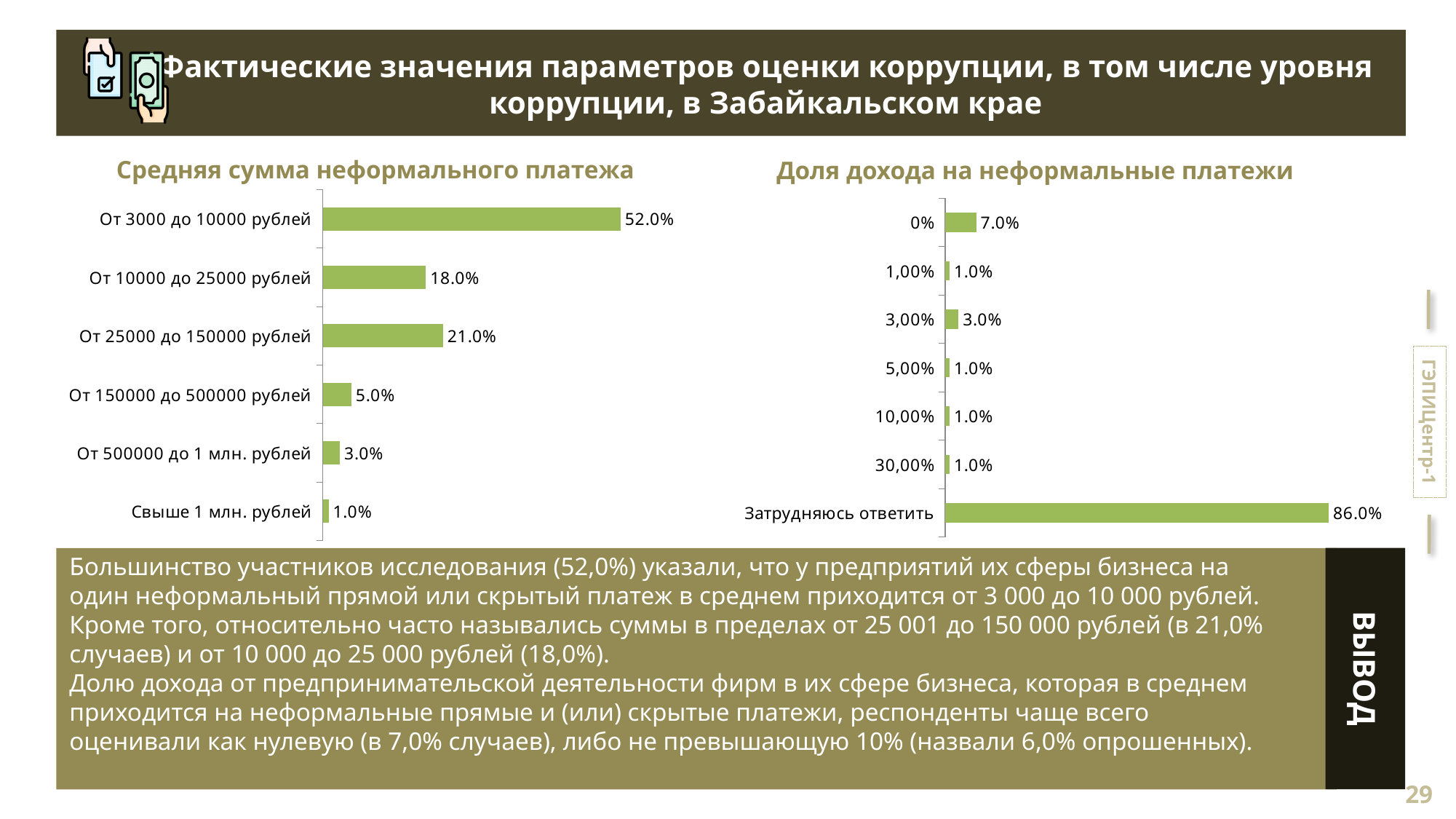
In the chart 'Доля дохода на неформальные платежи', what is the difference between '0%' and '3,00%'? 4.0% In the chart 'Средняя сумма неформального платежа', what is the difference between 'От 25000 до 150000 рублей' and 'От 10000 до 25000 рублей'? 3.0% In the chart 'Доля дохода на неформальные платежи', which category has the highest value? Затрудняюсь ответить How many categories are shown in the chart 'Доля дохода на неформальные платежи'? 7 In the chart 'Средняя сумма неформального платежа', which is larger: 'От 10000 до 25000 рублей' or 'От 25000 до 150000 рублей'? От 25000 до 150000 рублей In the chart 'Средняя сумма неформального платежа', which category has the lowest value? Свыше 1 млн. рублей In the chart 'Доля дохода на неформальные платежи', what is the value for '3,00%'? 3.0% In the chart 'Средняя сумма неформального платежа', what is the value for 'От 150000 до 500000 рублей'? 5.0% In the chart 'Доля дохода на неформальные платежи', what is the value for 'Затрудняюсь ответить'? 86.0% In the chart 'Средняя сумма неформального платежа', what is the value for 'От 3000 до 10000 рублей'? 52.0% What type of chart is 'Доля дохода на неформальные платежи'? Bar chart How many categories are shown in the chart 'Средняя сумма неформального платежа'? 6